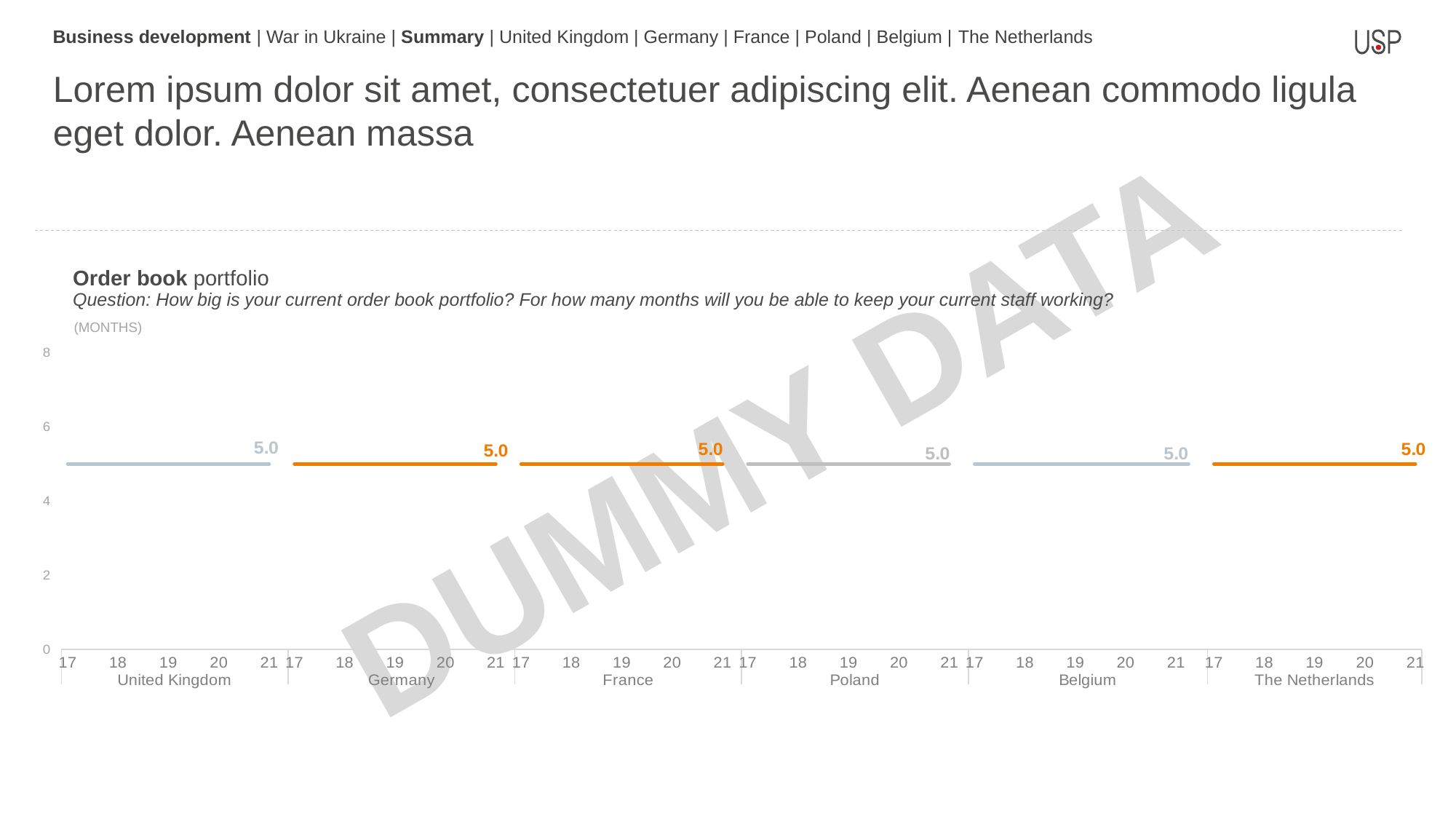
What is the difference between the value for France in 21 and the value for Belgium in 21? 0.0 What is the value shown for Poland in 21? 5.0 What is the value shown for The Netherlands in 21? 5.0 What kind of chart is shown on the slide? line chart In what unit are the values on the chart expressed? months What is the value shown for Germany in 21? 5.0 How many years are shown for each country on the x axis? 5 How many countries are shown on the x axis of the chart? 6 Is the value for France in 21 greater or less than 6? less What is the value shown for the United Kingdom in 21? 5.0 Is the value for Belgium in 21 greater or less than 4? greater Do the values for Germany rise, fall or stay flat from 17 to 21? stay flat